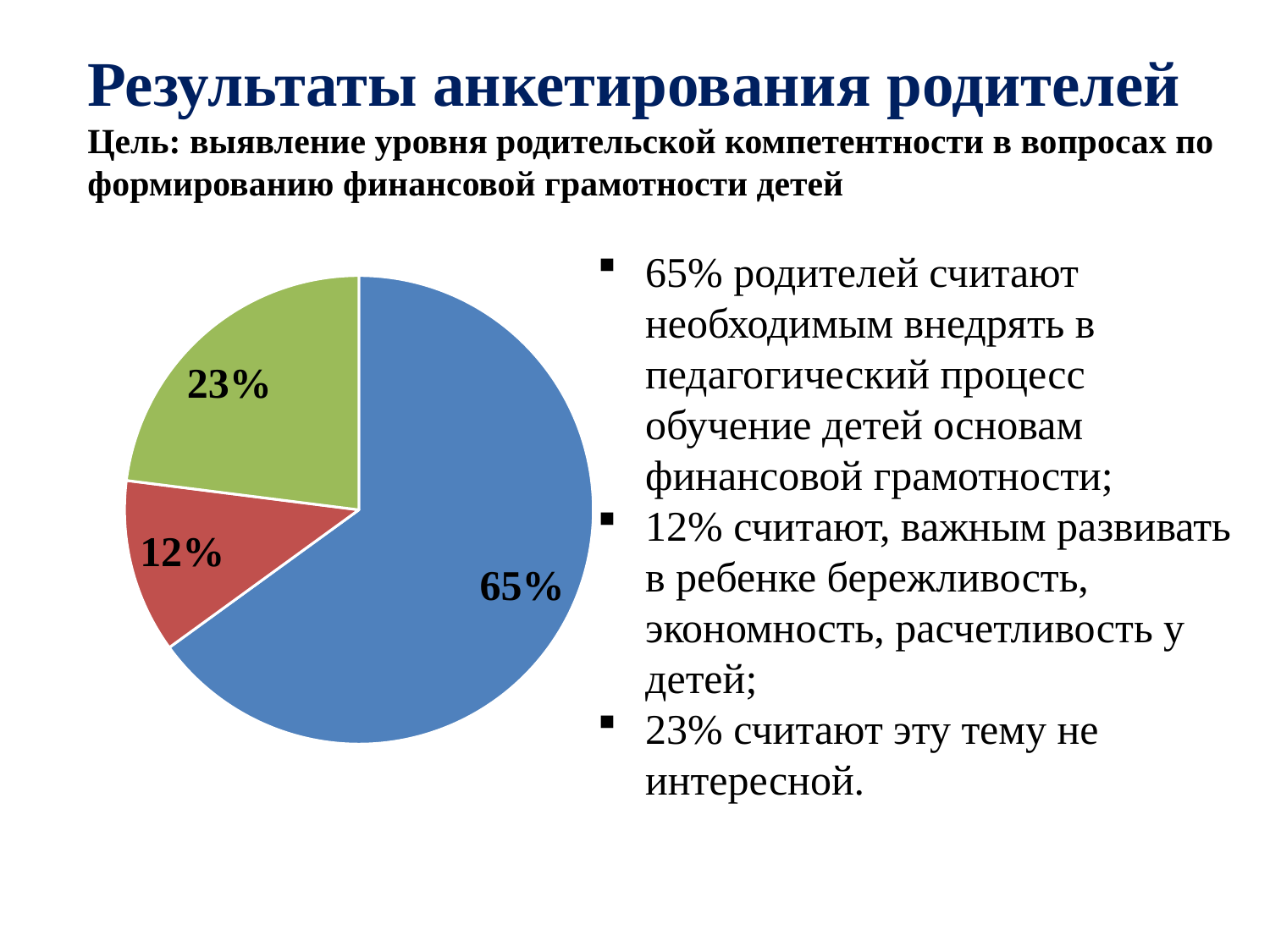
What colour is the largest slice of the pie chart? blue What share of the pie is taken by the slice representing parents who consider the topic not interesting? 23% Which slice of the pie chart is the largest? 65% How many slices does the pie chart have? 3 What is the difference between the largest and smallest slices of the pie chart? 53% What is the difference between the green slice and the red slice of the pie chart? 11% What kind of chart is shown on the slide? pie chart Which is larger in the pie chart, the green slice or the red slice? green slice What value is labelled on the blue slice of the pie chart? 65% Which slice of the pie chart is the smallest? 12% What value is labelled on the red slice of the pie chart? 12% What value is labelled on the green slice of the pie chart? 23%